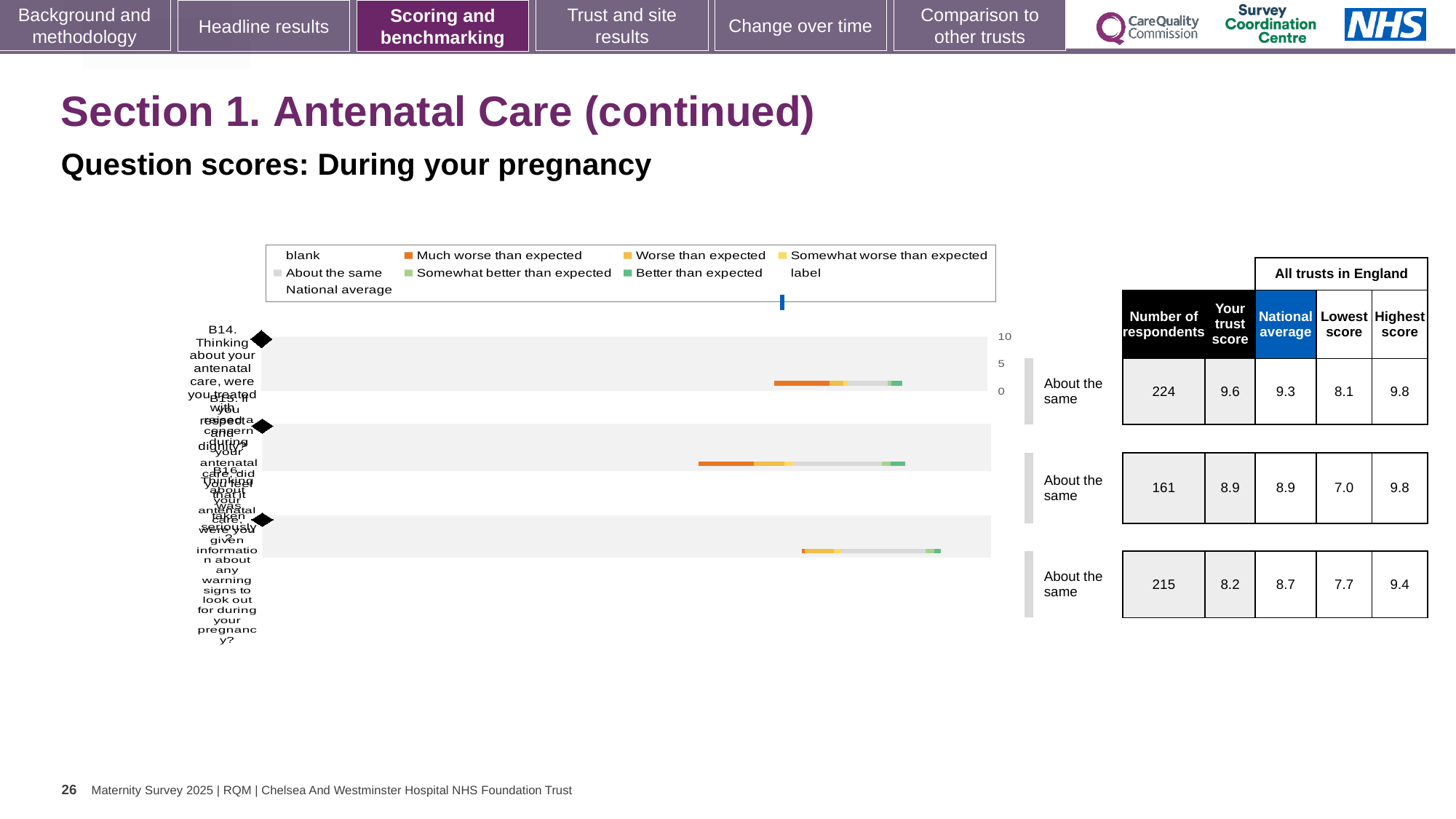
Which row has the highest number of respondents in the table beside the chart? B14 (first row) Which row has the lowest 'Your trust score' in the table beside the chart? third row (B16) In the table beside the chart, what is the number of respondents for the first row (B14)? 224 Is 'Your trust score' larger for the first row (B14) or the third row (B16)? first row (B14) What kind of chart is shown on the slide? bar chart What is the highest tick value shown on the chart's axis? 10 In the table beside the chart, what is the national average for the third row (B16)? 8.7 In the table beside the chart, what is 'Your trust score' for the first row (B14)? 9.6 How many question rows (bars) are plotted in the chart? 3 In the table beside the chart, what is the lowest score for the second row? 7.0 In the chart legend, what colour represents 'Much worse than expected'? orange What is the difference between the national average and 'Your trust score' for the third row (B16)? 0.5